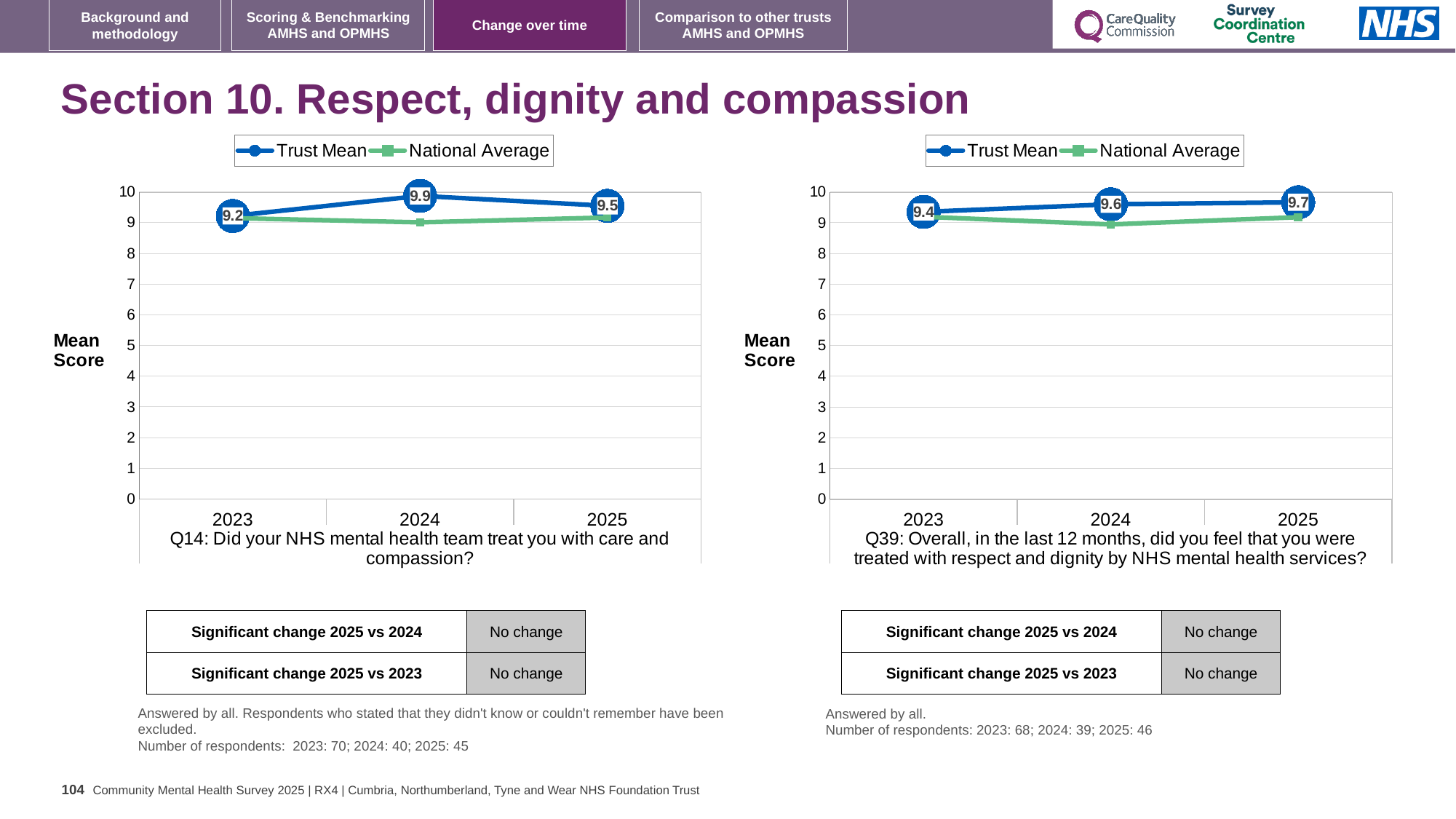
On the Q14 chart (left), is the Trust Mean higher in 2025 or in 2023? 2025 What kind of chart is the Q39 chart (right)? line chart On the Q39 chart (right), does the Trust Mean rise or fall from 2023 to 2025? rise On the Q39 chart (right), what is the Trust Mean for 2023? 9.4 On the Q14 chart (left), which year has the highest Trust Mean? 2024 On the Q39 chart (right), what is the Trust Mean for 2025? 9.7 On the Q39 chart (right), what is the difference between the Trust Mean in 2025 and in 2023? 0.3 How many series does the legend of the Q14 chart (left) list? 2 On the Q14 chart (left), what is the Trust Mean for 2024? 9.9 On the Q14 chart (left), what is the Trust Mean for 2023? 9.2 On the Q14 chart (left), what is the difference between the Trust Mean in 2024 and in 2023? 0.7 On the Q39 chart (right), which year has the lowest Trust Mean? 2023